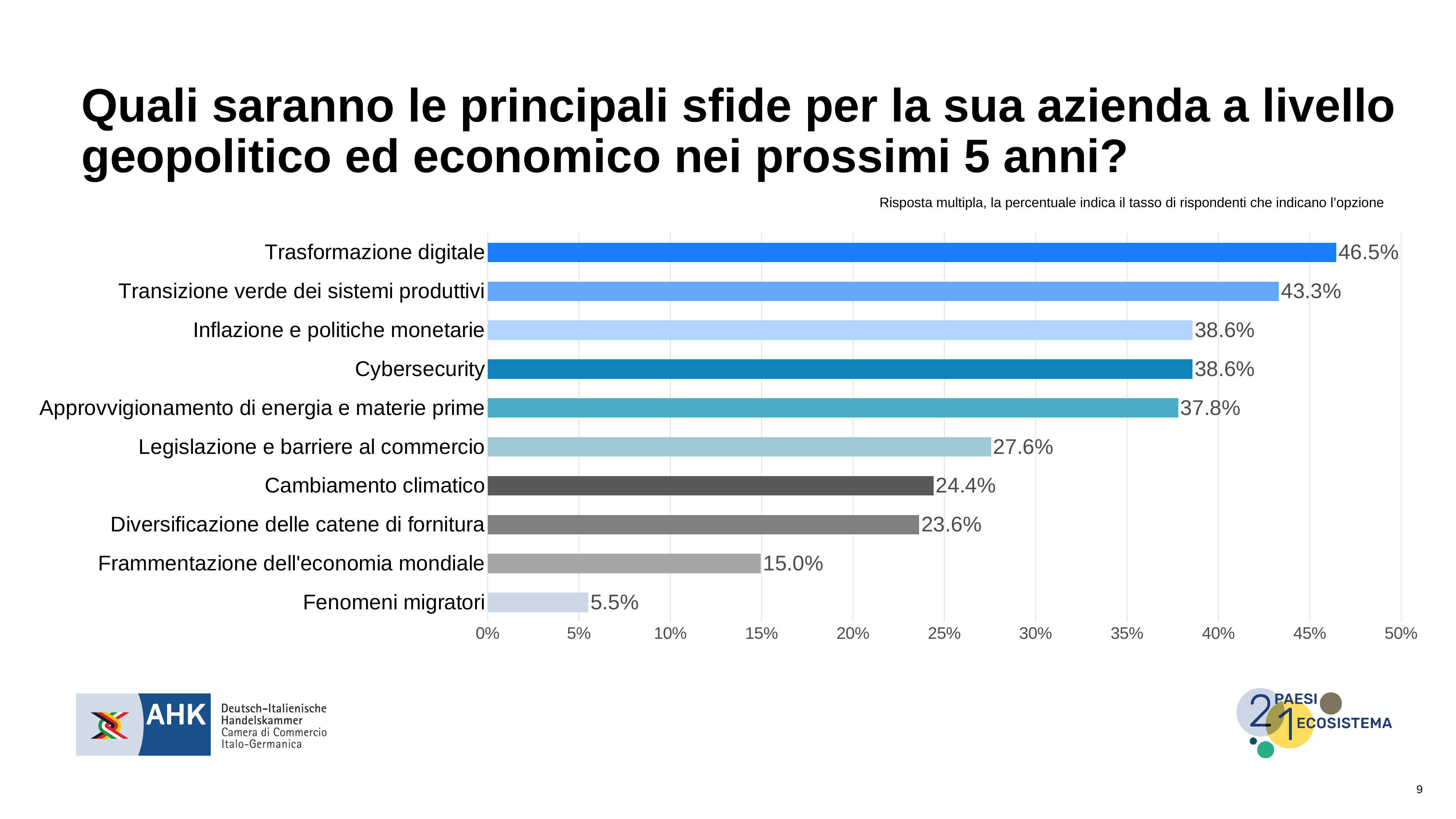
What is the difference between the values for Cambiamento climatico and Diversificazione delle catene di fornitura? 0.8% Which category has the highest value? Trasformazione digitale What is the value for Trasformazione digitale? 46.5% Which category has the lowest value? Fenomeni migratori What is the value for Legislazione e barriere al commercio? 27.6% What kind of chart is shown on the slide? Bar chart What is the difference between the values for Trasformazione digitale and Transizione verde dei sistemi produttivi? 3.2% How many categories are shown in the chart? 10 What is the value for Fenomeni migratori? 5.5% What is the maximum value shown on the horizontal axis? 50% What is the value for Frammentazione dell'economia mondiale? 15.0% Which is larger, the value for Approvvigionamento di energia e materie prime or the value for Legislazione e barriere al commercio? Approvvigionamento di energia e materie prime